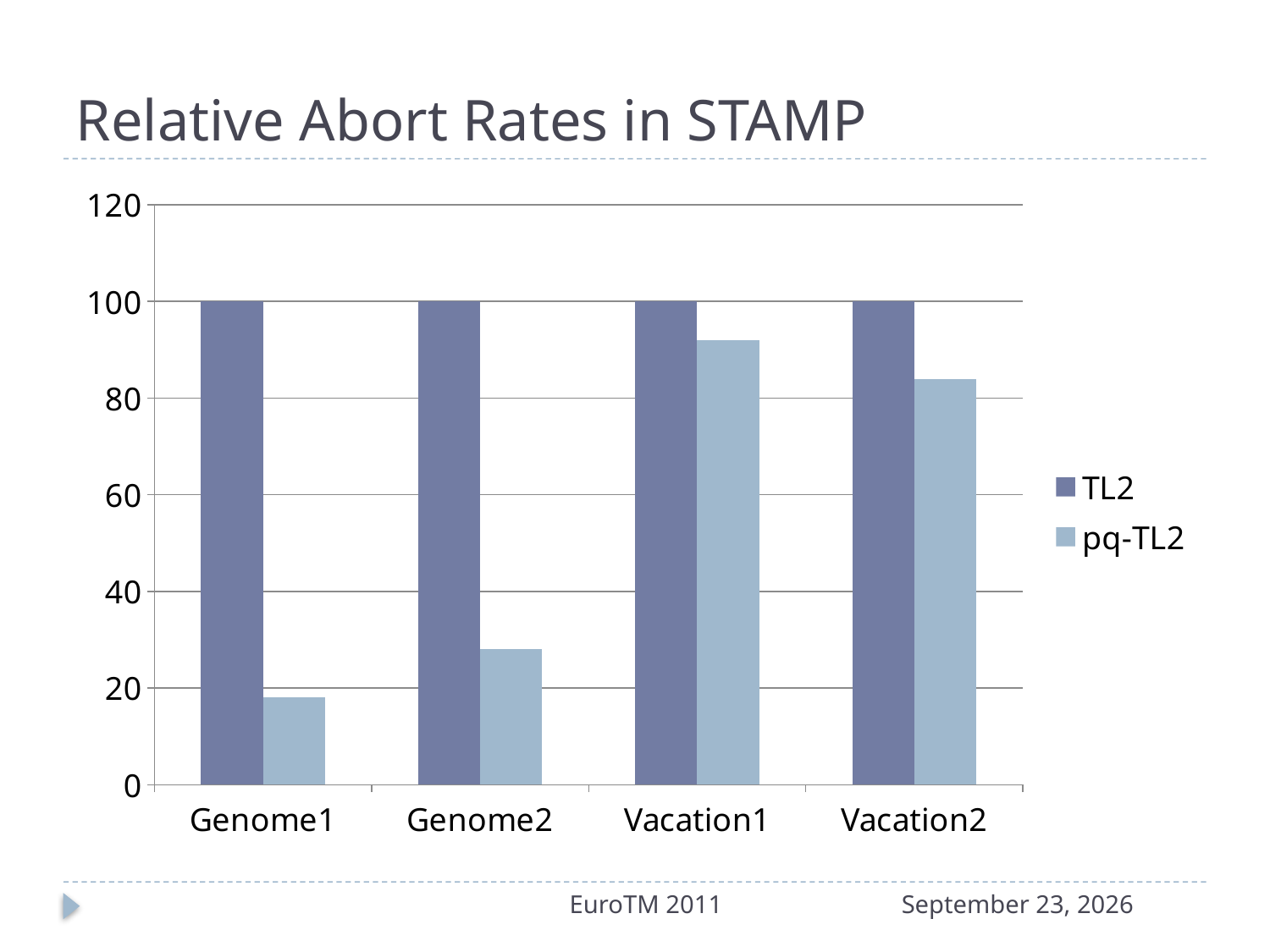
Which category has the highest pq-TL2 value? Vacation1 Which is larger, the pq-TL2 value for Genome2 or for Vacation2? Vacation2 What kind of chart is shown on the slide? bar chart Is the pq-TL2 value for Genome2 greater or less than 20? greater How many series does the chart's legend list? 2 Is the pq-TL2 value for Genome1 greater or less than 20? less Is the pq-TL2 value for Vacation1 greater or less than 80? greater Which category has the lowest pq-TL2 value? Genome1 What is the TL2 value for Genome1? 100 How many categories are shown on the x axis of the chart? 4 What is the TL2 value for Vacation2? 100